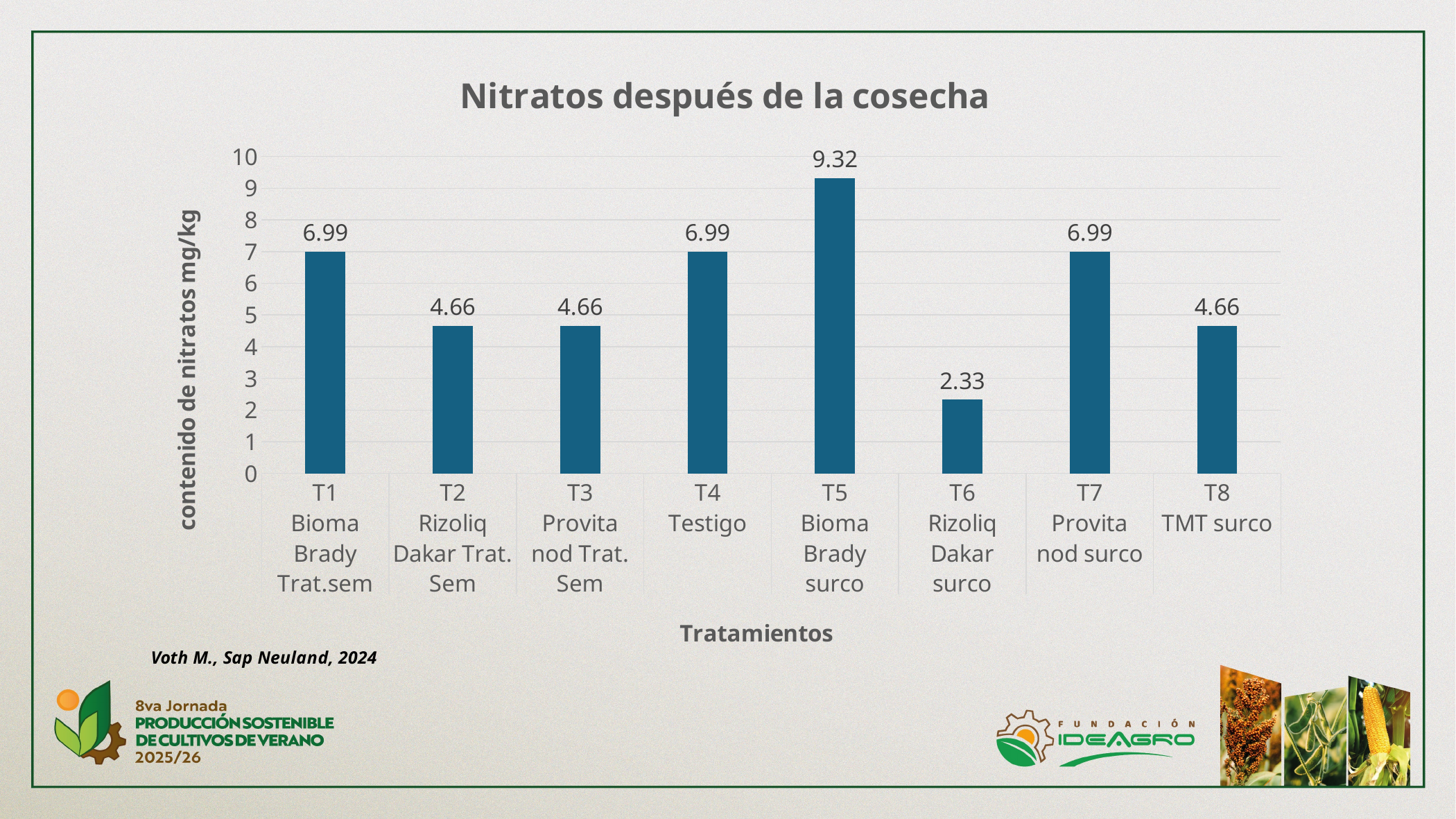
How many treatments are shown on the x axis? 8 Which treatment has the highest nitrate content? T5 Bioma Brady surco What is the difference between the values for T1 and T2? 2.33 What is the nitrate content for T5 Bioma Brady surco? 9.32 What is the nitrate content for T6 Rizoliq Dakar surco? 2.33 What is the difference between the values for T5 and T6? 6.99 What kind of chart is this? Bar chart What is the title of the chart? Nitratos después de la cosecha Which treatment has the lowest nitrate content? T6 Rizoliq Dakar surco Which is larger, the value for T3 Provita nod Trat. Sem or T7 Provita nod surco? T7 Provita nod surco What is the value for T4 Testigo? 6.99 What is the value for T8 TMT surco? 4.66